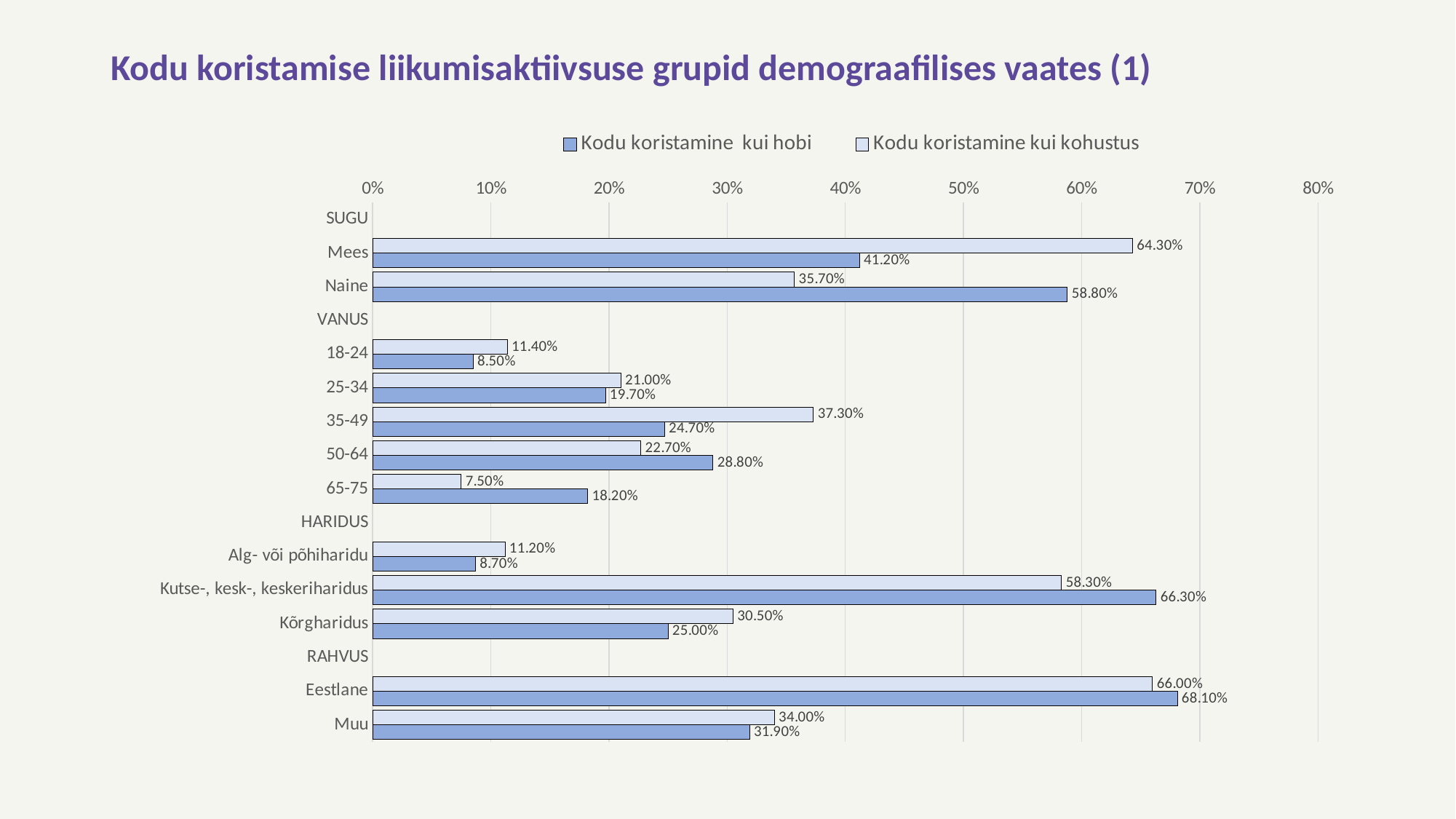
What kind of chart is shown on the slide? bar chart What is the value for Naine in the 'Kodu koristamine kui hobi' series? 58.80% For 50-64, which series has the larger value: 'Kodu koristamine kui hobi' or 'Kodu koristamine kui kohustus'? Kodu koristamine kui hobi Is the 'Kodu koristamine kui hobi' value for Kutse-, kesk-, keskeriharidus greater or less than 60%? greater Which category has the highest value in the 'Kodu koristamine kui hobi' series? Eestlane What is the value for Muu in the 'Kodu koristamine kui hobi' series? 31.90% Which category has the lowest value in the 'Kodu koristamine kui kohustus' series? 65-75 What is the value for 65-75 in the 'Kodu koristamine kui kohustus' series? 7.50% How many series does the legend list? 2 What is the difference between the 'Kodu koristamine kui kohustus' and 'Kodu koristamine kui hobi' values for Mees? 23.10% What is the title of the chart? Kodu koristamise liikumisaktiivsuse grupid demograafilises vaates (1) What is the value for Mees in the 'Kodu koristamine kui kohustus' series? 64.30%